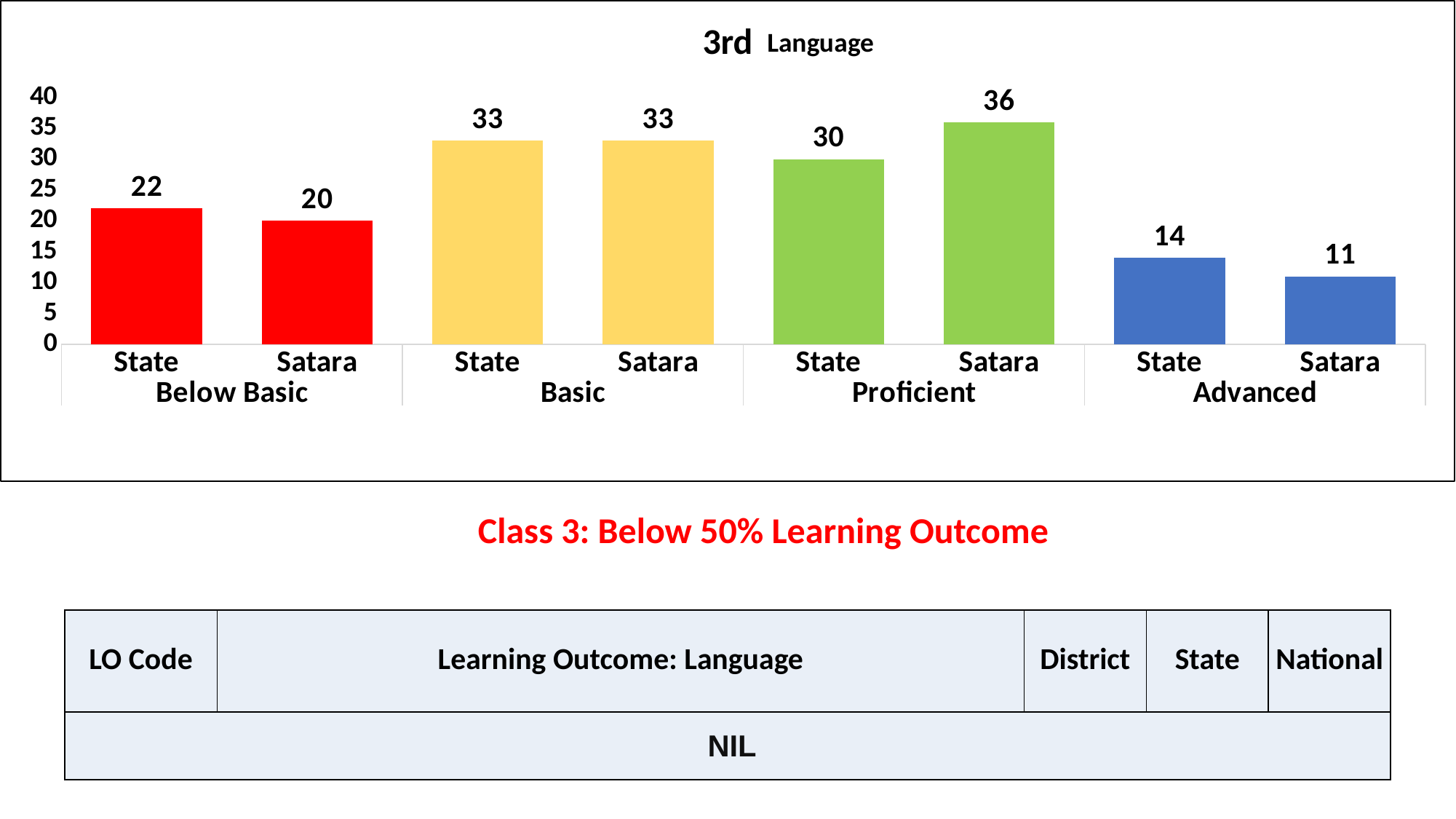
What is the difference between State and Satara in the Advanced group? 3 What kind of chart is shown on the slide? bar chart Is the value for Satara in the Proficient group greater or less than 35? greater What is the value for Satara in the Proficient group? 36 What is the value for State in the Below Basic group? 22 What is the difference between Satara and State in the Proficient group? 6 Which is larger in the Below Basic group, State or Satara? State Which bar has the lowest value on the chart? Satara, Advanced What is the title of the chart? 3rd Language What is the value for Satara in the Advanced group? 11 How many bars are plotted on the chart? 8 Which bar has the highest value on the chart? Satara, Proficient